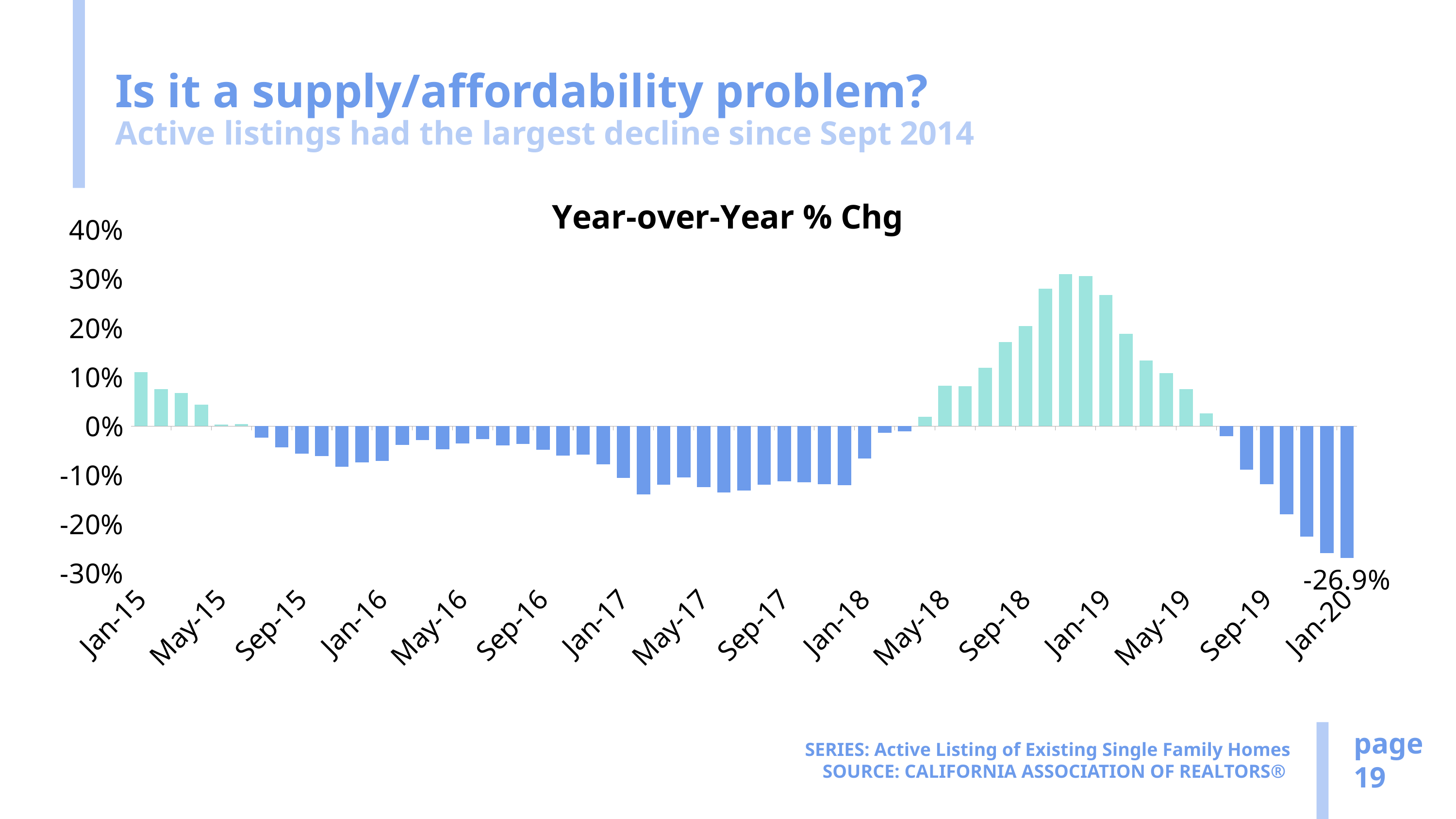
Is the value for Jan-19 greater or less than 20%? greater Which is larger, the value for Jan-19 or the value for Jan-20? Jan-19 Do the values rise or fall from Jan-19 to Jan-20? fall What colour are the bars with negative values? blue What kind of chart is shown on the slide? bar chart Which is larger, the value for Jan-15 or the value for Jan-16? Jan-15 Which month has the lowest year-over-year % change? Jan-20 Is the value for Jan-17 greater or less than 0%? less What is the year-over-year % change for Jan-20? -26.9% What is the title of the chart? Year-over-Year % Chg Is the value for Sep-18 greater or less than 10%? greater